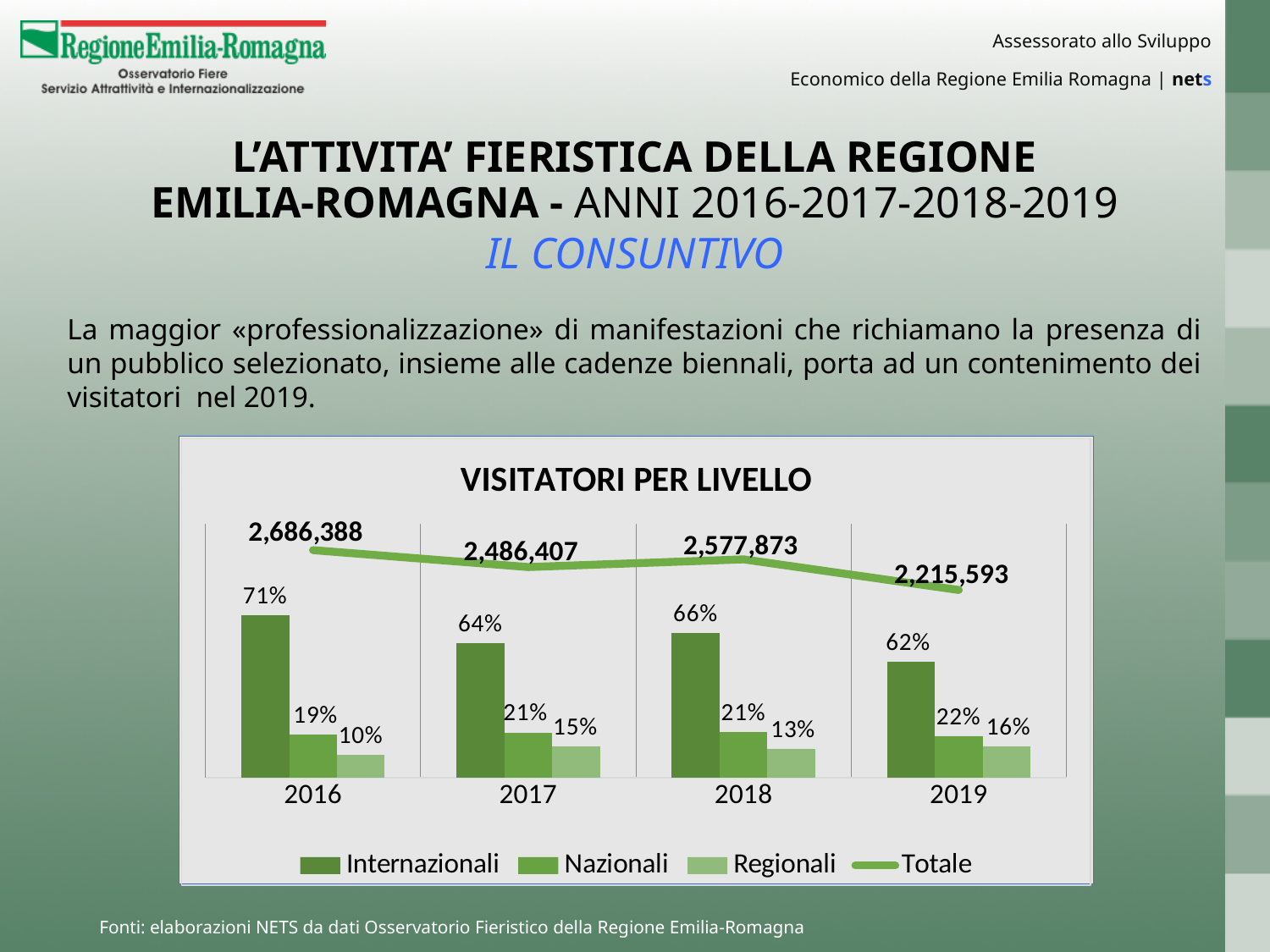
How many series does the legend list? 4 What is the Totale value for 2016? 2,686,388 Which is larger, the Nazionali share in 2016 or the Nazionali share in 2019? 2019 How many years are shown on the x axis? 4 What is the Internazionali share in 2017? 64% In which year is the Internazionali share lowest? 2019 In which year is the Totale value highest? 2016 Does the Regionali share rise or fall from 2016 to 2017? rise What is the title of the chart? VISITATORI PER LIVELLO What is the Regionali share in 2018? 13% What is the Totale value for 2019? 2,215,593 What is the difference between the Totale values for 2018 and 2019? 362,280